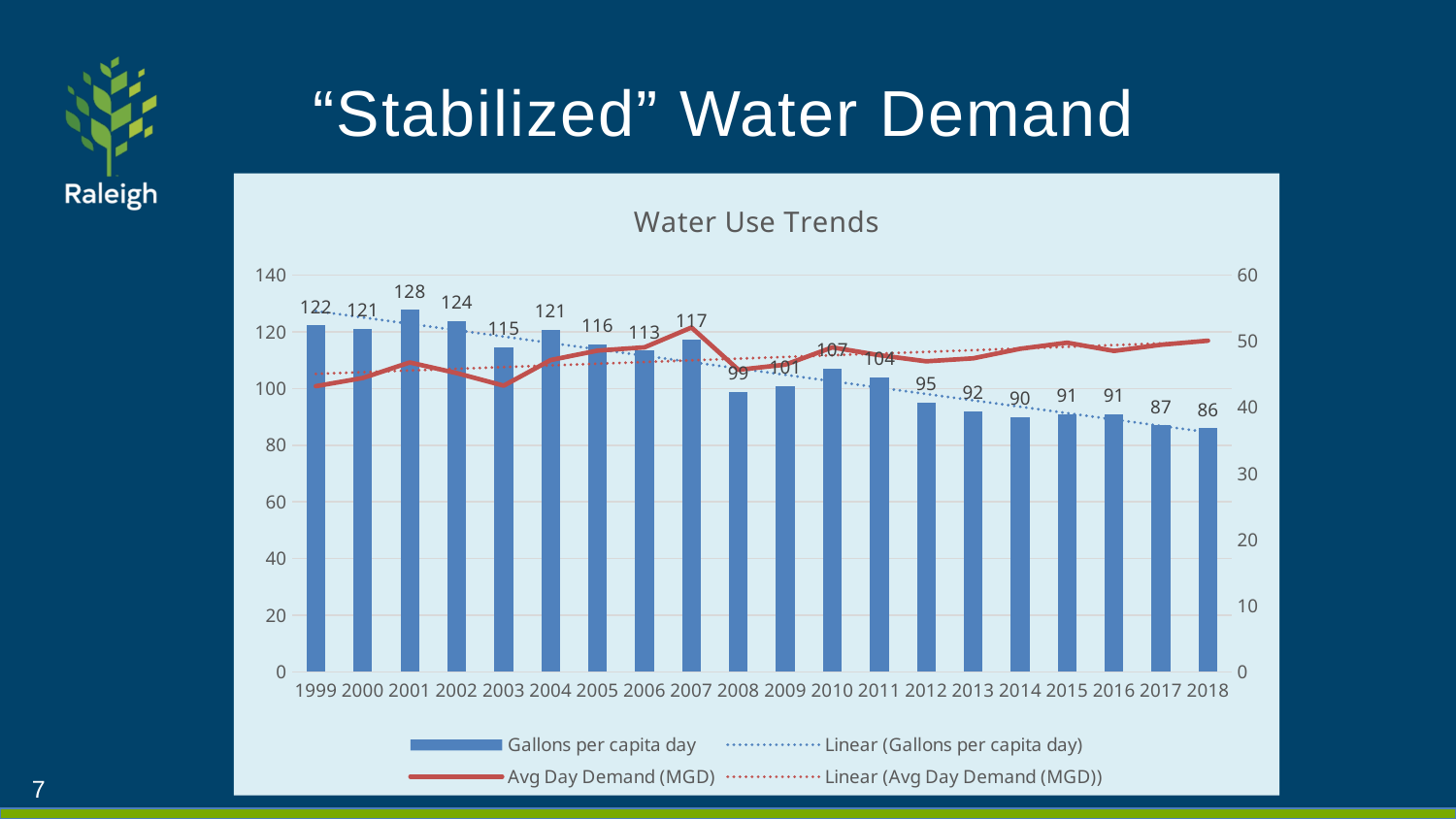
Which year has the highest Gallons per capita day value? 2001 What is the Gallons per capita day value for 2001? 128 How many years are shown on the x axis? 20 What is the Gallons per capita day value for 2018? 86 Which year has a larger Gallons per capita day value, 2010 or 2012? 2010 What is the Gallons per capita day value for 2008? 99 What is the title of the chart? Water Use Trends Is the Avg Day Demand (MGD) value for 2018 greater or less than 40 on the right axis? greater How many entries does the legend list? 4 Which year has the lowest Gallons per capita day value? 2018 What is the difference between the Gallons per capita day values for 1999 and 2018? 36 Do the Gallons per capita day values generally rise or fall from 1999 to 2018? fall